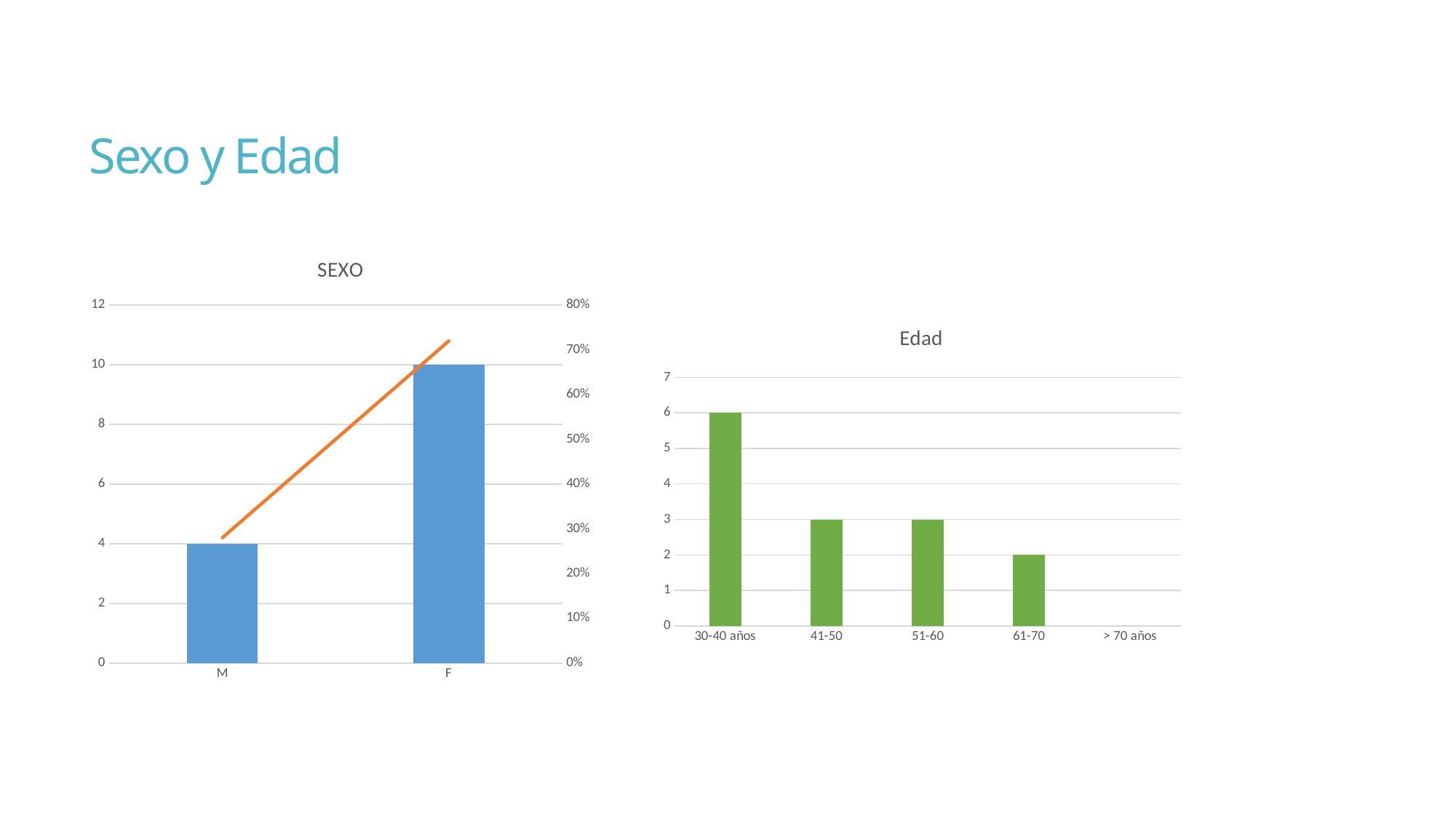
In the SEXO chart, what is the bar value for F? 10 In the Edad chart, what is the difference between the values for 30-40 años and 61-70? 4 In the Edad chart, how many age categories are shown on the x axis? 5 In the SEXO chart, is the line value for F greater or less than 60%? greater In the Edad chart, what is the value for 30-40 años? 6 In the SEXO chart, which category has the taller bar? F What kind of chart is the Edad chart? bar chart In the SEXO chart, what is the bar value for M? 4 In the Edad chart, what is the value for 61-70? 2 In the SEXO chart, what is the difference between the bar values for F and M? 6 In the Edad chart, which age group has the highest value? 30-40 años